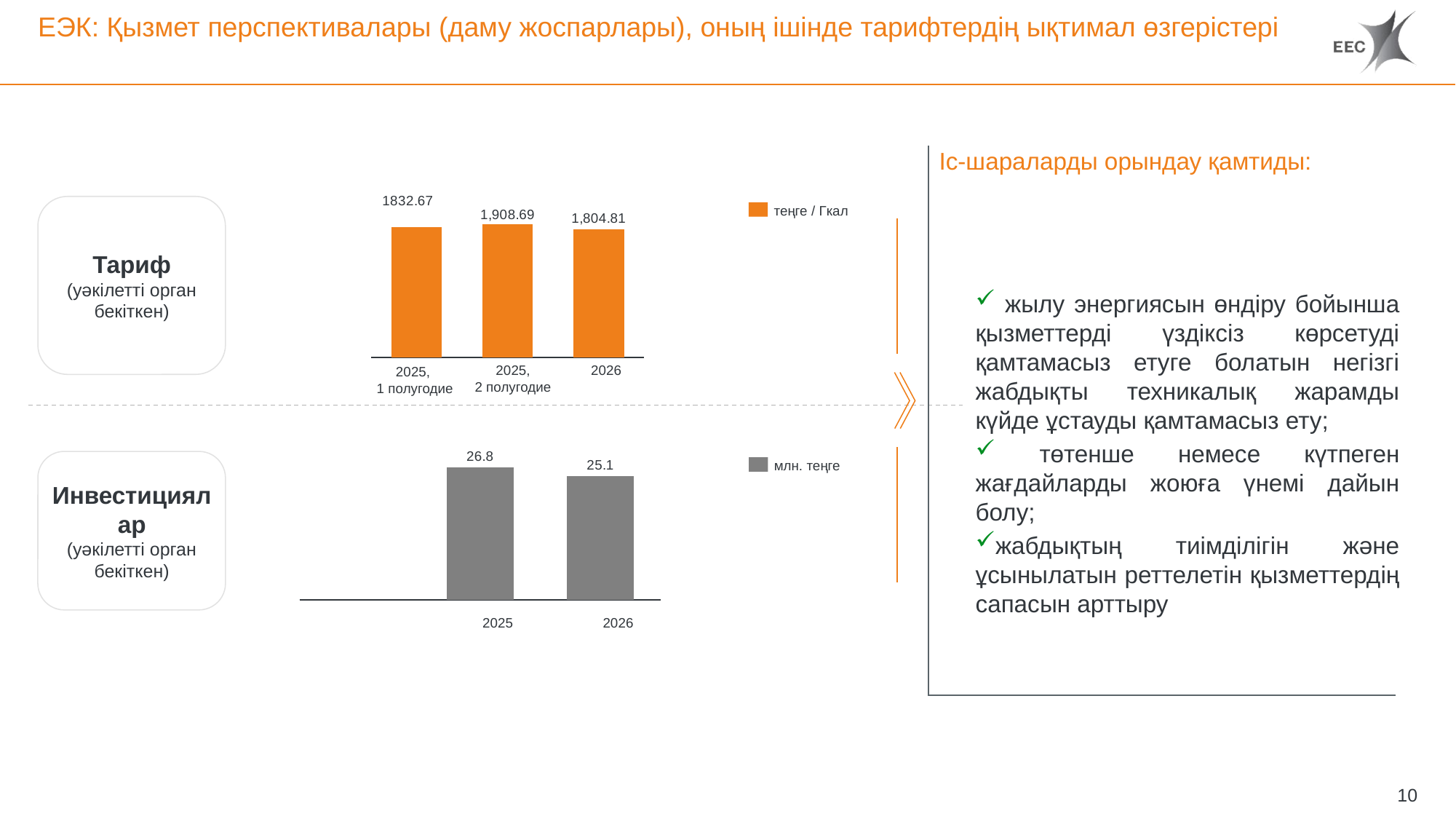
In the top (Тариф) chart, what is the value for 2026? 1,804.81 In the top (Тариф) chart, which category has the lowest value? 2026 In the bottom (Инвестициялар) chart, what is the value for 2026? 25.1 How many bars are in the top (Тариф) chart? 3 What type of chart is the bottom (Инвестициялар) chart? bar chart In the top (Тариф) chart, which category has the highest value? 2025, 2 полугодие In the top (Тариф) chart, what is the difference between the values for 2025, 2 полугодие and 2026? 103.88 What unit does the legend of the top (Тариф) chart show? теңге / Гкал In the bottom (Инвестициялар) chart, what is the value for 2025? 26.8 In the top (Тариф) chart, what is the value for 2025, 2 полугодие? 1,908.69 In the top (Тариф) chart, what is the value for 2025, 1 полугодие? 1832.67 In the bottom (Инвестициялар) chart, what is the difference between the values for 2025 and 2026? 1.7